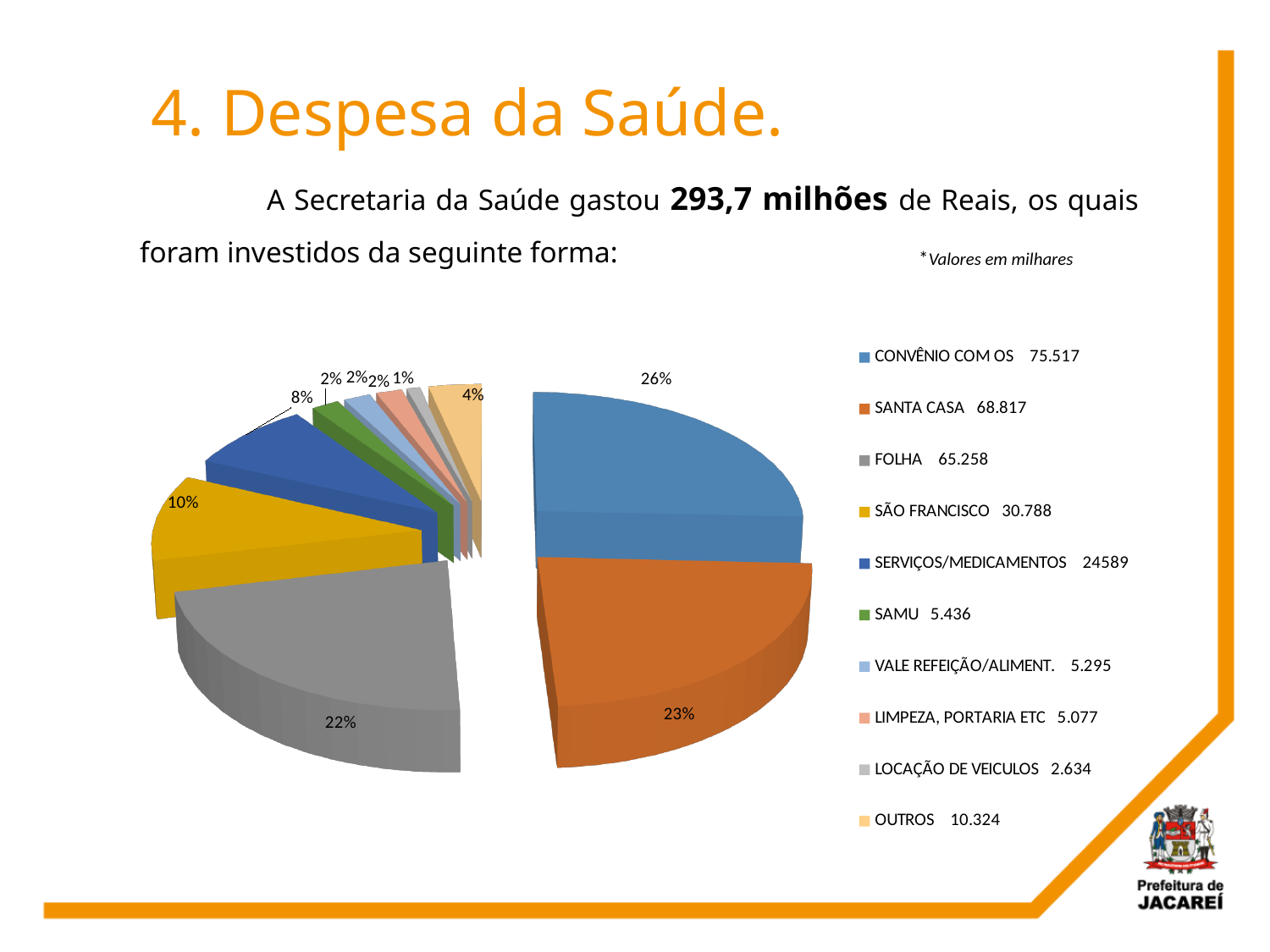
What value is shown in the legend for OUTROS? 10.324 What is the difference between the legend values for CONVÊNIO COM OS and SANTA CASA? 6.700 What share of the pie does FOLHA represent? 22% What value is shown in the legend for SAMU? 5.436 Which category has the smallest value in the pie chart? LOCAÇÃO DE VEICULOS How many categories does the pie chart's legend list? 10 What share of the pie does SANTA CASA represent? 23% What share of the pie does SÃO FRANCISCO represent? 10% Which category has the largest value in the pie chart? CONVÊNIO COM OS What value is shown in the legend for SERVIÇOS/MEDICAMENTOS? 24589 What kind of chart is shown on the slide? pie chart